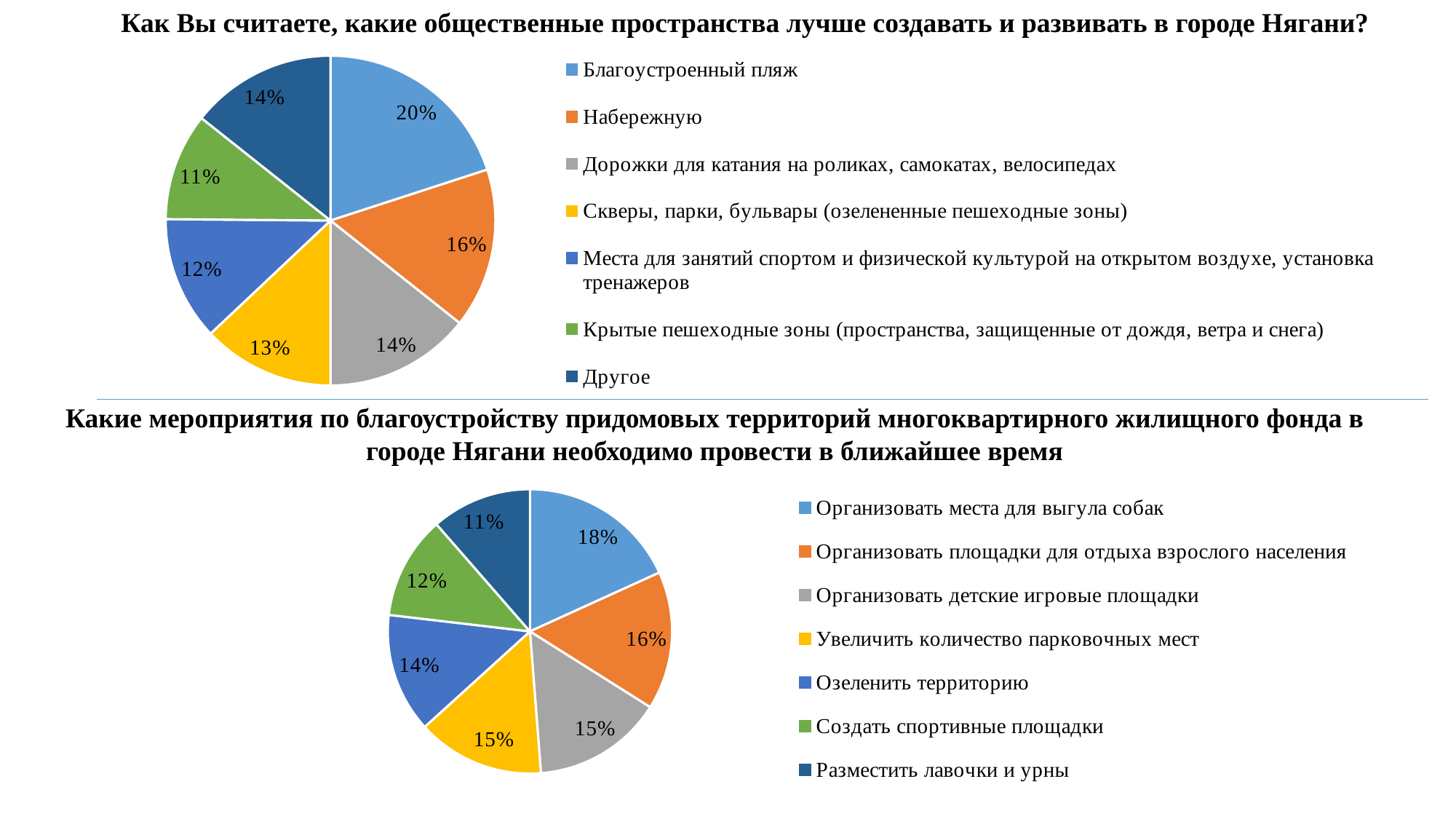
In the top chart, what colour is the slice for "Другое"? Dark blue In the top chart, which category has the smallest slice? Крытые пешеходные зоны (пространства, защищенные от дождя, ветра и снега) In the top chart ("Как Вы считаете, какие общественные пространства лучше создавать и развивать в городе Нягани?"), what share does "Благоустроенный пляж" have? 20% In the top chart, what is the difference between the shares of "Благоустроенный пляж" and "Скверы, парки, бульвары (озелененные пешеходные зоны)"? 7% In the bottom chart, what percentage is shown for "Озеленить территорию"? 14% In the bottom chart ("Какие мероприятия по благоустройству придомовых территорий..."), what share does "Организовать места для выгула собак" have? 18% What type of chart is the bottom chart? Pie chart In the bottom chart, which is larger: "Организовать площадки для отдыха взрослого населения" or "Создать спортивные площадки"? Организовать площадки для отдыха взрослого населения In the top chart, which category has the largest slice? Благоустроенный пляж In the bottom chart, which category has the smallest share? Разместить лавочки и урны In the top chart, what percentage is shown for "Набережную"? 16% In the top chart, how many categories does the legend list? 7